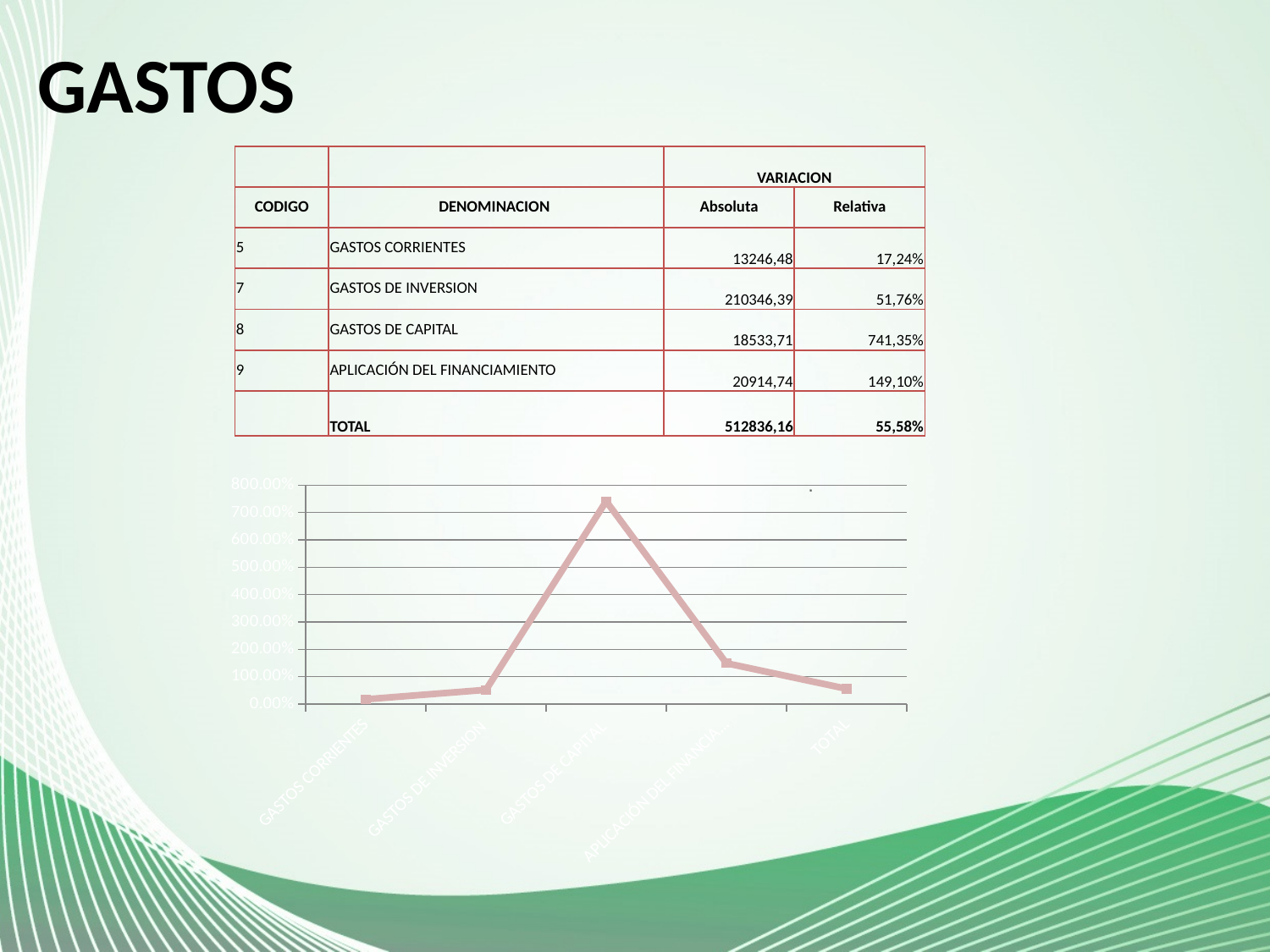
On the line chart, which is larger: the value for APLICACIÓN DEL FINANCIAMIENTO or the value for TOTAL? APLICACIÓN DEL FINANCIAMIENTO On the line chart, which is larger: the value for GASTOS DE CAPITAL or the value for APLICACIÓN DEL FINANCIAMIENTO? GASTOS DE CAPITAL Does the line rise or fall between GASTOS DE CAPITAL and TOTAL on the line chart? fall Is the value for GASTOS DE CAPITAL on the line chart greater or less than 700.00%? greater Is the value for TOTAL on the line chart greater or less than 100.00%? less How many data points are plotted on the line chart? 5 Which category has the highest value on the line chart? GASTOS DE CAPITAL Is the value for GASTOS CORRIENTES on the line chart greater or less than 100.00%? less What is the highest value shown on the vertical axis of the line chart? 800.00% What kind of chart is shown on the slide? line chart Which category has the lowest value on the line chart? GASTOS CORRIENTES